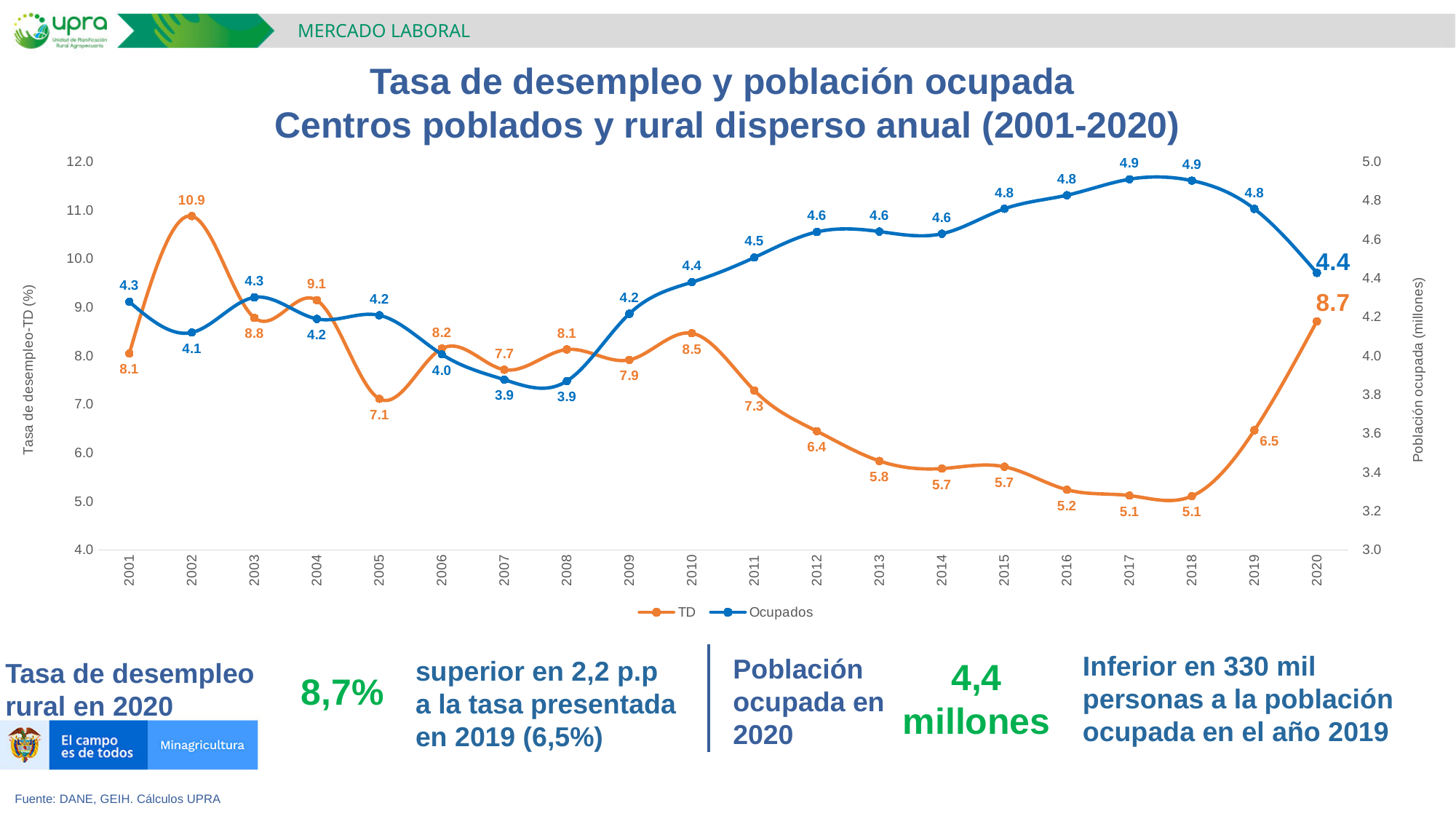
How many years are plotted on the x axis? 20 What is the TD value for 2002? 10.9 What is the TD value for 2019? 6.5 What is the Ocupados value for 2006? 4.0 Does the TD series rise or fall from 2011 to 2018? Fall How many series does the legend list? 2 Which year has the larger Ocupados value, 2008 or 2015? 2015 Which year has the larger TD value, 2010 or 2011? 2010 What is the Ocupados value for 2020? 4.4 What kind of chart is shown on the slide? Line chart In which year is the TD series at its highest? 2002 What is the difference between the TD value in 2020 and the TD value in 2019? 2.2